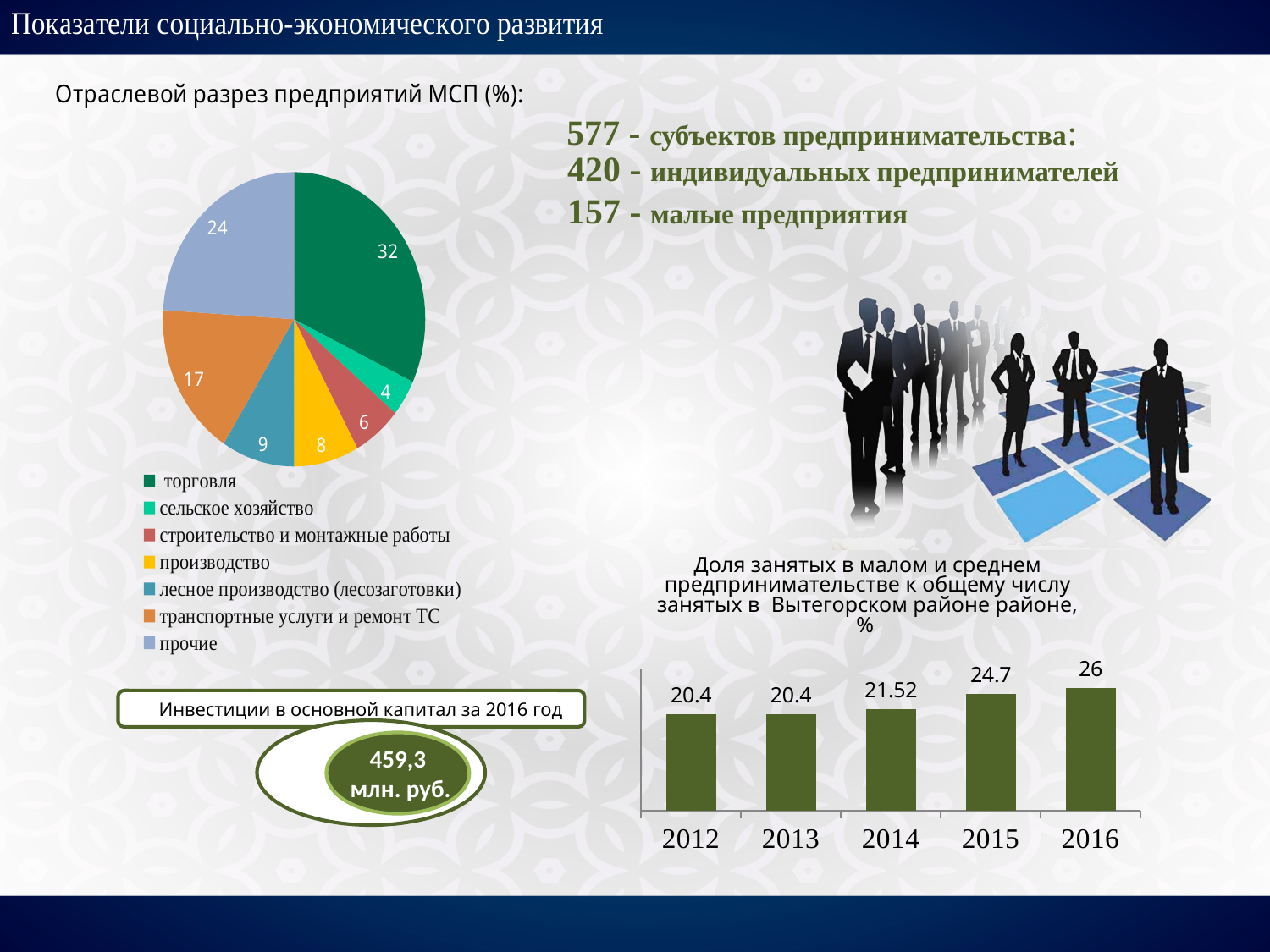
In the pie chart 'Отраслевой разрез предприятий МСП (%)', which category has the largest slice? торговля In the pie chart 'Отраслевой разрез предприятий МСП (%)', what is the value for торговля? 32 In the bar chart 'Доля занятых в малом и среднем предпринимательстве...', what is the value for 2015? 24.7 In the bar chart 'Доля занятых в малом и среднем предпринимательстве...', do the values rise or fall from 2012 to 2016? rise In the pie chart 'Отраслевой разрез предприятий МСП (%)', which is larger: лесное производство (лесозаготовки) or строительство и монтажные работы? лесное производство (лесозаготовки) In the pie chart 'Отраслевой разрез предприятий МСП (%)', which category has the smallest slice? сельское хозяйство In the pie chart 'Отраслевой разрез предприятий МСП (%)', how many categories does the legend list? 7 What kind of chart is the chart at the bottom right of the slide showing values by year? bar chart In the bar chart 'Доля занятых в малом и среднем предпринимательстве...', which year has the highest value? 2016 In the pie chart 'Отраслевой разрез предприятий МСП (%)', what is the difference between прочие and производство? 16 In the pie chart 'Отраслевой разрез предприятий МСП (%)', what is the value for транспортные услуги и ремонт ТС? 17 In the bar chart 'Доля занятых в малом и среднем предпринимательстве...', what is the difference between 2016 and 2012? 5.6